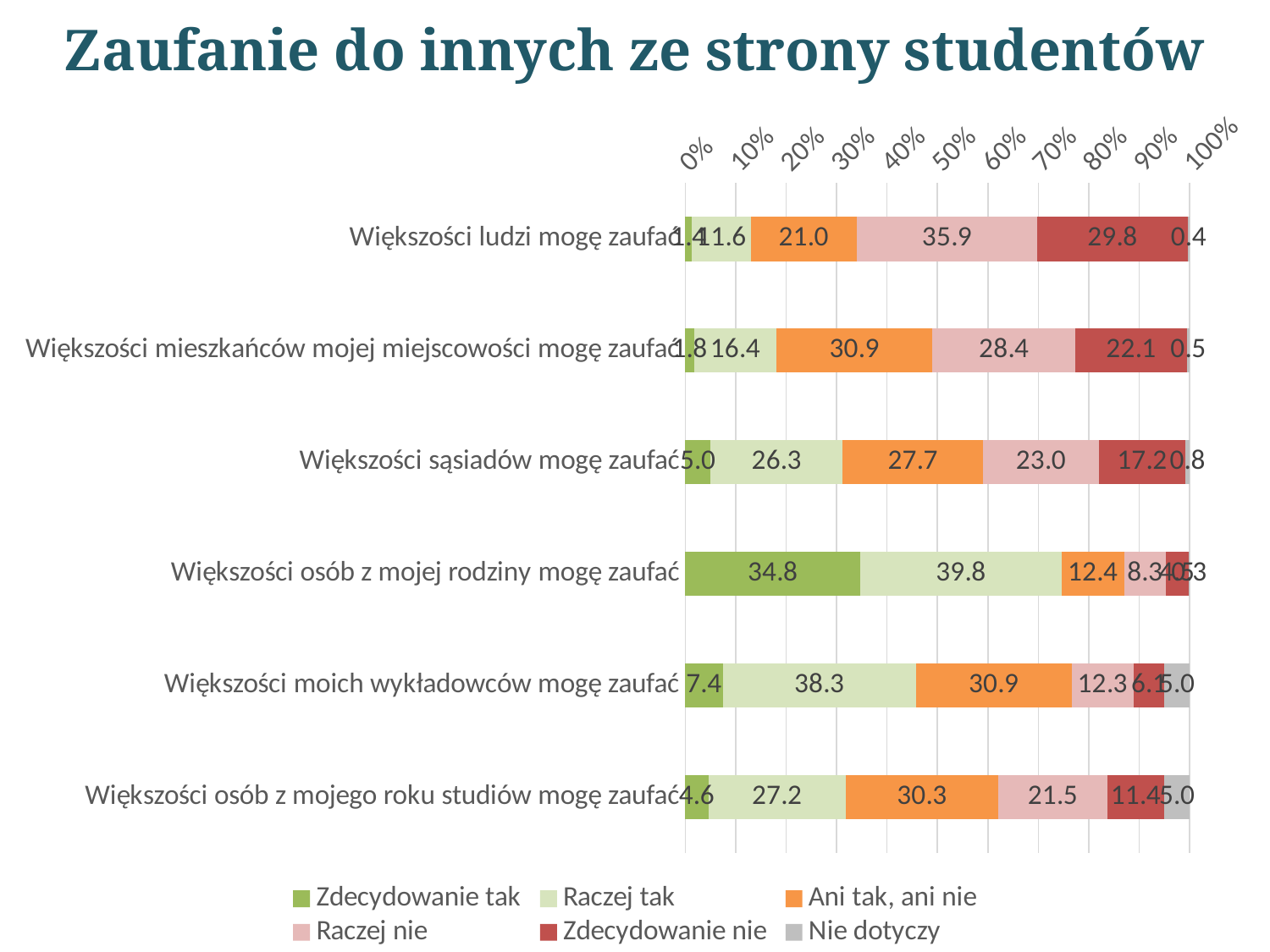
Which category has the highest 'Zdecydowanie nie' value? Większości ludzi mogę zaufać How many categories (statements) are plotted on the chart? 6 What is the value of 'Ani tak, ani nie' for 'Większości mieszkańców mojej miejscowości mogę zaufać'? 30.9 How many series does the legend list? 6 Which is larger: the 'Ani tak, ani nie' value for 'Większości ludzi mogę zaufać' or for 'Większości sąsiadów mogę zaufać'? Większości sąsiadów mogę zaufać What is the value of 'Zdecydowanie tak' for 'Większości osób z mojej rodziny mogę zaufać'? 34.8 Which category has the highest 'Zdecydowanie tak' value? Większości osób z mojej rodziny mogę zaufać What is the value of 'Raczej nie' for 'Większości ludzi mogę zaufać'? 35.9 What is the value of 'Raczej nie' for 'Większości osób z mojego roku studiów mogę zaufać'? 21.5 What is the difference between the 'Raczej nie' values for 'Większości ludzi mogę zaufać' and 'Większości mieszkańców mojej miejscowości mogę zaufać'? 7.5 What kind of chart is shown on the slide? Stacked bar chart What is the value of 'Raczej tak' for 'Większości moich wykładowców mogę zaufać'? 38.3